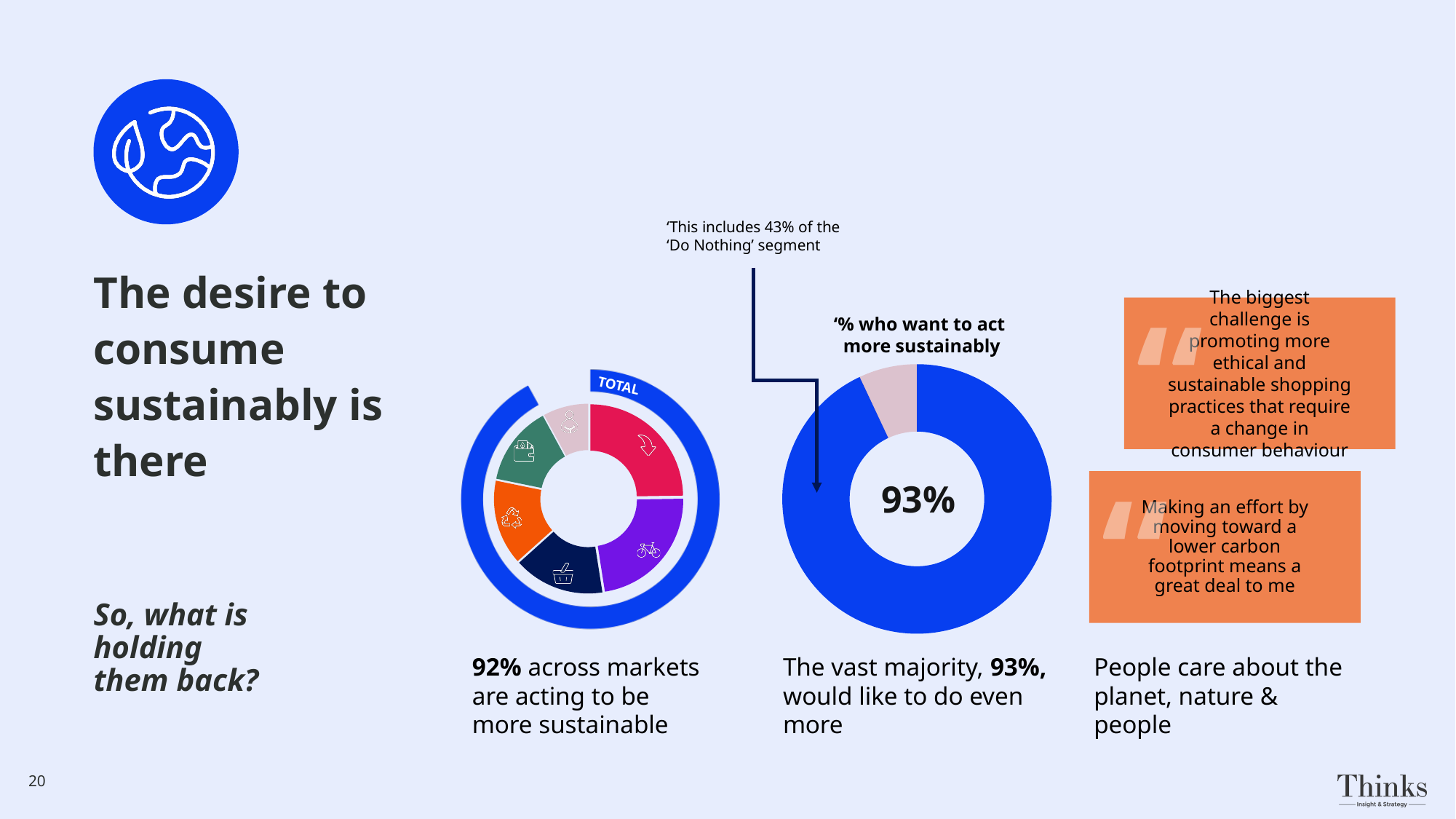
What is the title of the chart on the right of the slide? % who want to act more sustainably How many slices does the '% who want to act more sustainably' chart have? 2 Is the blue slice in the '% who want to act more sustainably' chart greater or less than 50% of the pie? greater In the '% who want to act more sustainably' chart, which slice is larger, the blue one or the pink one? The blue one What kind of chart is the chart labelled 'TOTAL' on the left of the slide? Pie (donut) chart According to the caption under the 'TOTAL' chart on the left, what percentage across markets are acting to be more sustainable? 92% How many coloured segments does the inner ring of the 'TOTAL' chart on the left have? 6 According to the annotation on the '% who want to act more sustainably' chart, what share of the 'Do Nothing' segment is included? 43% What kind of chart is the '% who want to act more sustainably' chart? Pie (donut) chart What label appears on the outer ring of the left-hand donut chart? TOTAL In the '% who want to act more sustainably' chart, what percentage is shown in the centre? 93%